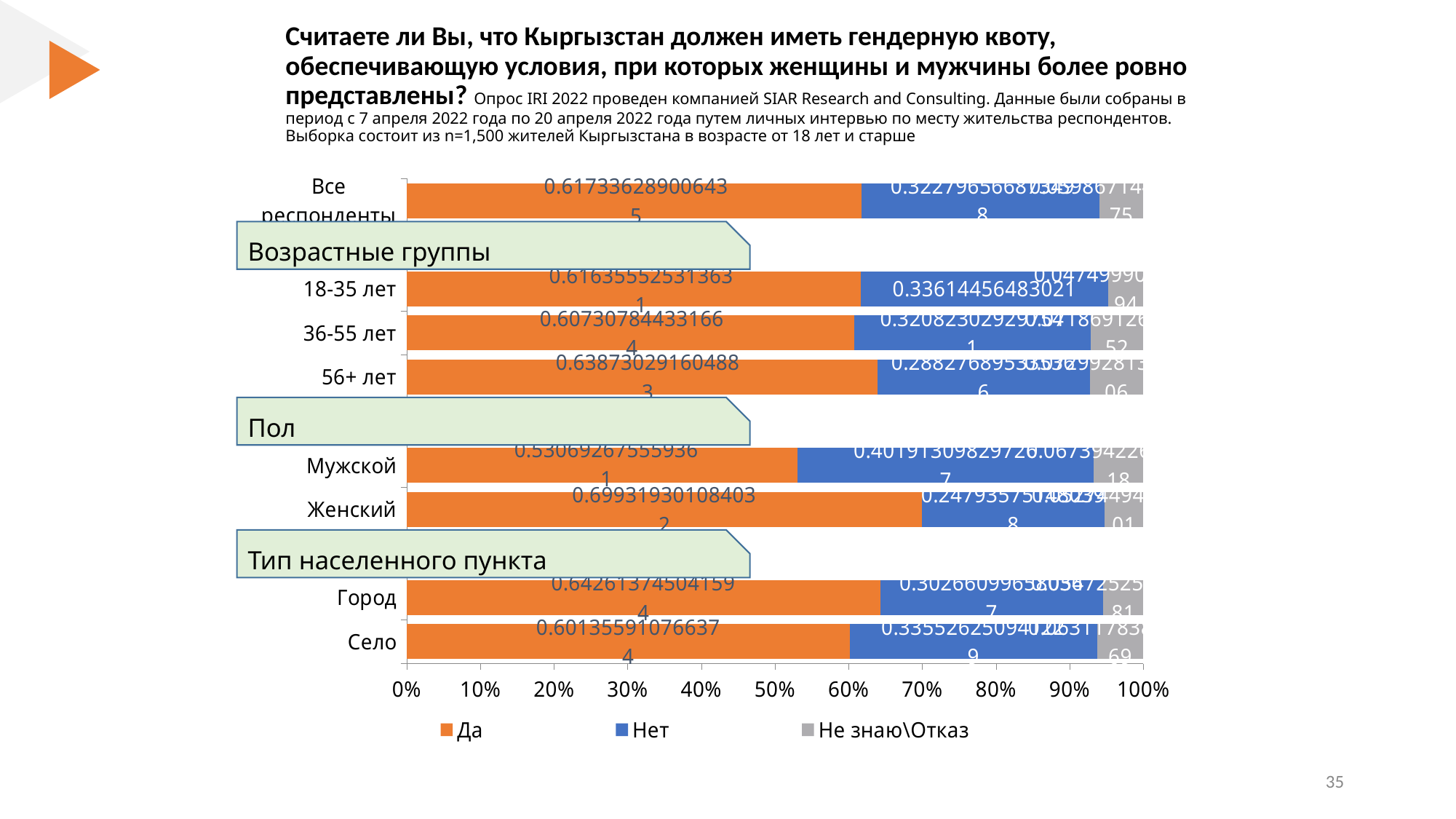
Is the 'Да' share for Женский greater or less than 60%? greater How many series does the legend list? 3 Is the 'Да' share for Мужской greater or less than 60%? less How many respondent categories (bars) are plotted in the chart? 8 Which category has the lowest share of 'Да' responses? Мужской Which has a larger 'Да' share: Город or Село? Город Which has a larger 'Да' share: Мужской or Женский? Женский What colour represents the 'Да' series in the chart? Orange What kind of chart is shown on the slide? Stacked bar chart Is the 'Да' share for 56+ лет greater or less than 50%? greater What are the three legend entries of the chart? Да, Нет, Не знаю\Отказ Which category has the highest share of 'Да' responses? Женский